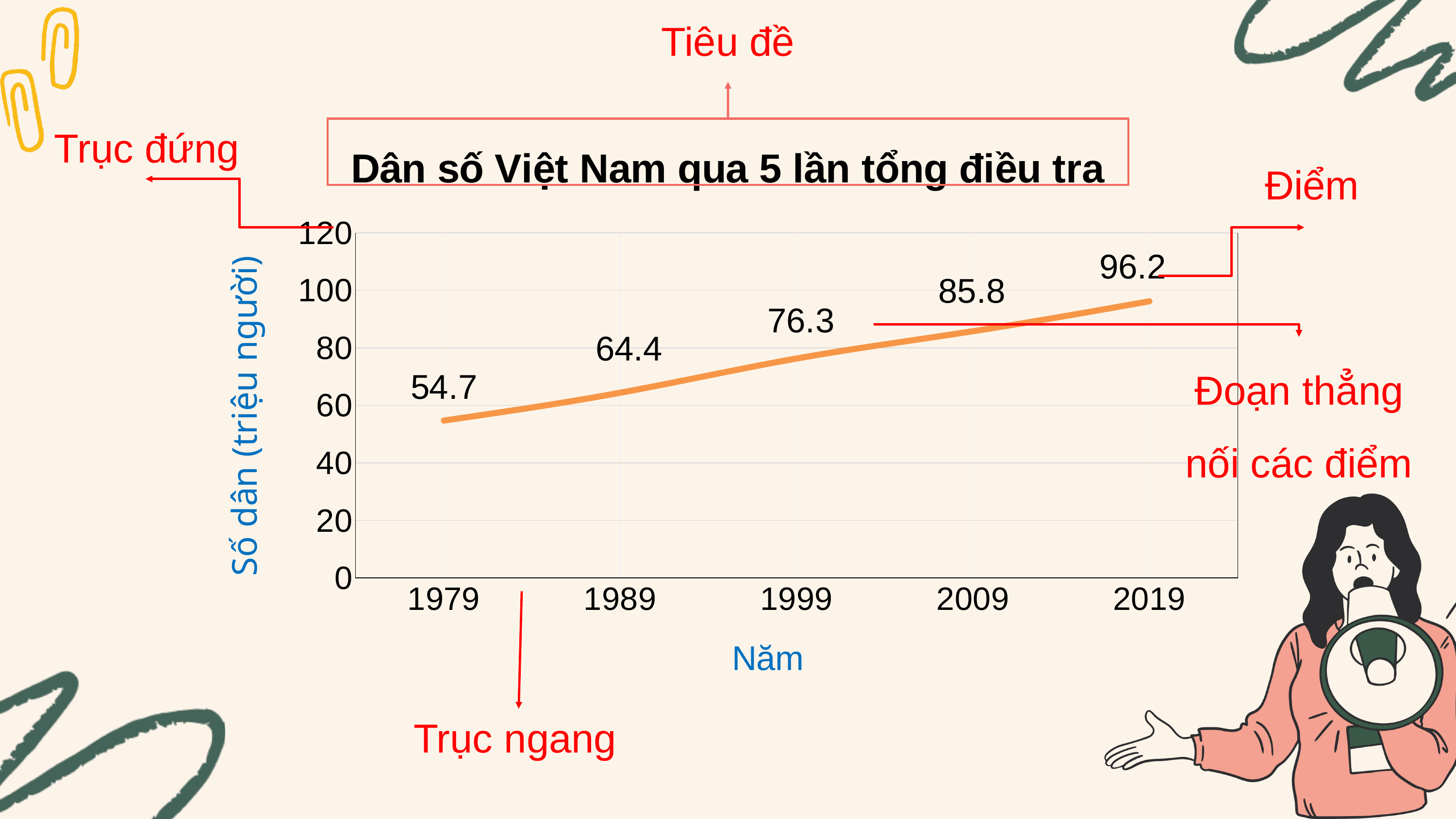
What is the difference between the values for 2009 and 1999? 9.5 Which year has the lowest population value? 1979 How many data points are plotted on the chart? 5 What kind of chart is shown on the slide? line chart What is the title of the chart? Dân số Việt Nam qua 5 lần tổng điều tra What is the difference between the values for 2019 and 1979? 41.5 Which is larger, the value for 1989 or the value for 2009? 2009 Which year has the highest population value? 2019 What value is shown for 2019? 96.2 What value is shown for 1999? 76.3 What was the population of Vietnam in 1979 according to the chart? 54.7 Do the values rise or fall from 1979 to 2019? rise